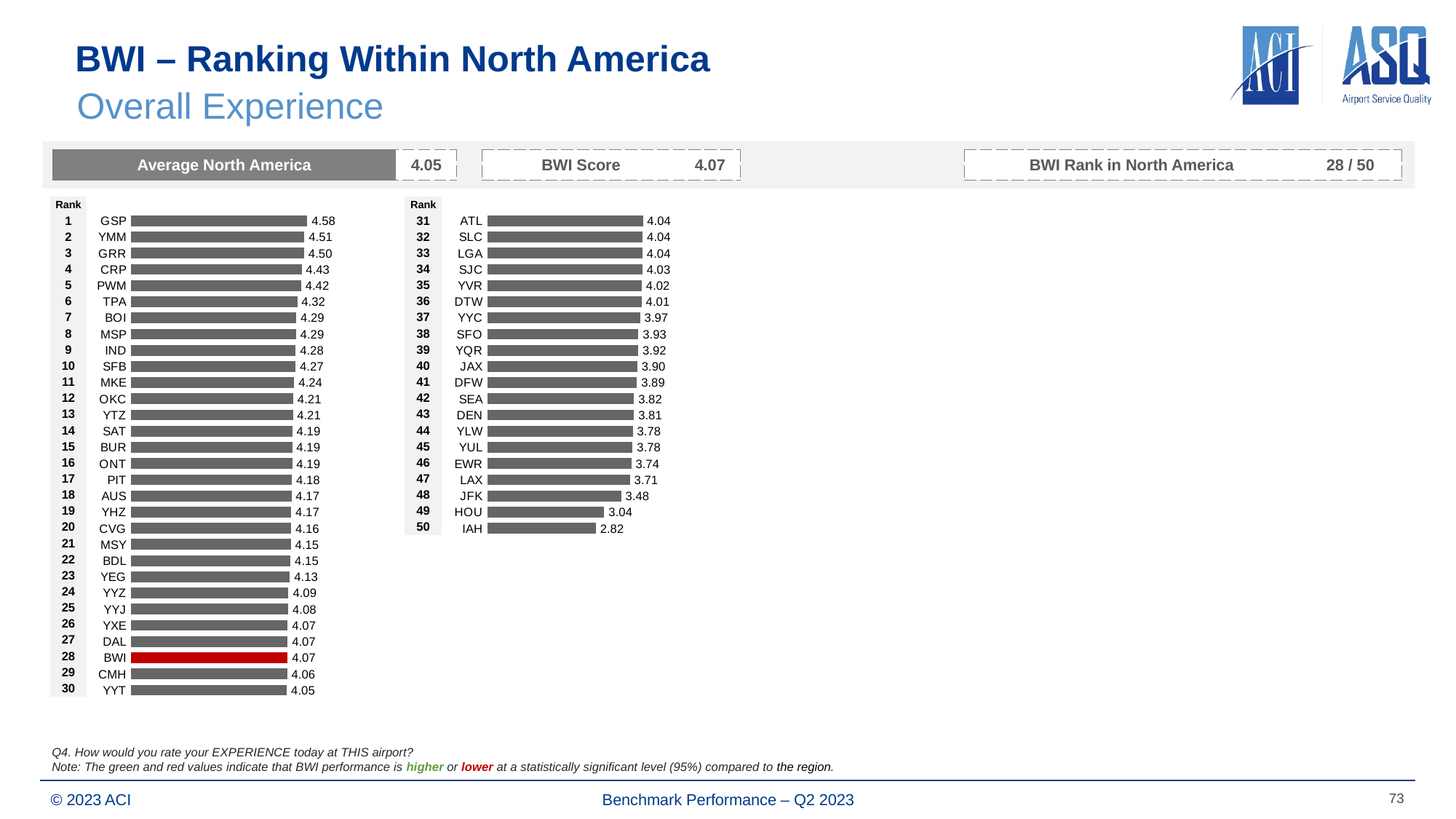
In the right chart (ranks 31–50), which airport has the lowest score? IAH In the right chart (ranks 31–50), what is the score for JFK? 3.48 In the left chart (ranks 1–30), what is the score for GSP? 4.58 How many airports are ranked in the right chart (ranks 31–50)? 20 How many airports are ranked in the left chart (ranks 1–30)? 30 Which bar in the left chart is highlighted in red? BWI In the left chart (ranks 1–30), what is the score for BWI? 4.07 What kind of chart is used to show the airport rankings? Bar chart In the left chart (ranks 1–30), which airport has the highest score? GSP Do the scores rise or fall as the rank number increases down the left chart? Fall Which has the higher score, TPA or LAX? TPA What is the difference between the scores of GSP and IAH? 1.76